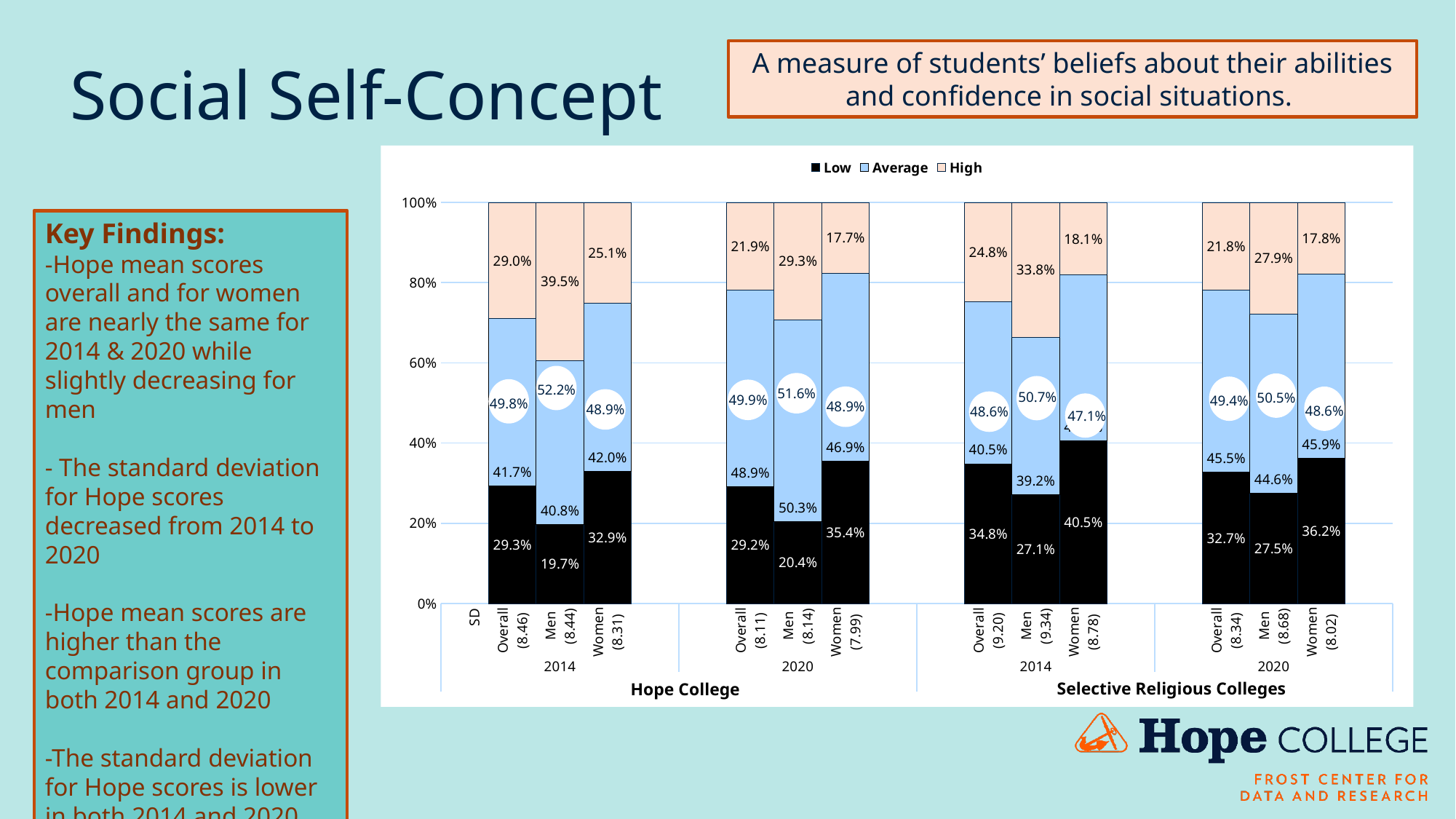
What is the Low percentage for Hope College Men in 2014? 19.7% What is the Average percentage for Selective Religious Colleges Overall in 2020? 45.5% What is the difference between the High percentage for Hope College Men in 2014 and Hope College Men in 2020? 10.2% Which is larger: the Low percentage for Hope College Women in 2020 or for Selective Religious Colleges Women in 2020? Selective Religious Colleges Women in 2020 (36.2%) What is the Low percentage for Selective Religious Colleges Women in 2014? 40.5% How many series does the legend list? 3 What is the High percentage for Hope College Women in 2020? 17.7% What standard deviation is shown in the axis label for Hope College Women in 2020? 7.99 Which Hope College 2014 group has the highest High percentage? Men (39.5%) What kind of chart is shown on the slide? Stacked bar chart Which bar has the lowest Low percentage across the whole chart? Hope College Men 2014 (19.7%) How many stacked bars are plotted in the chart? 12